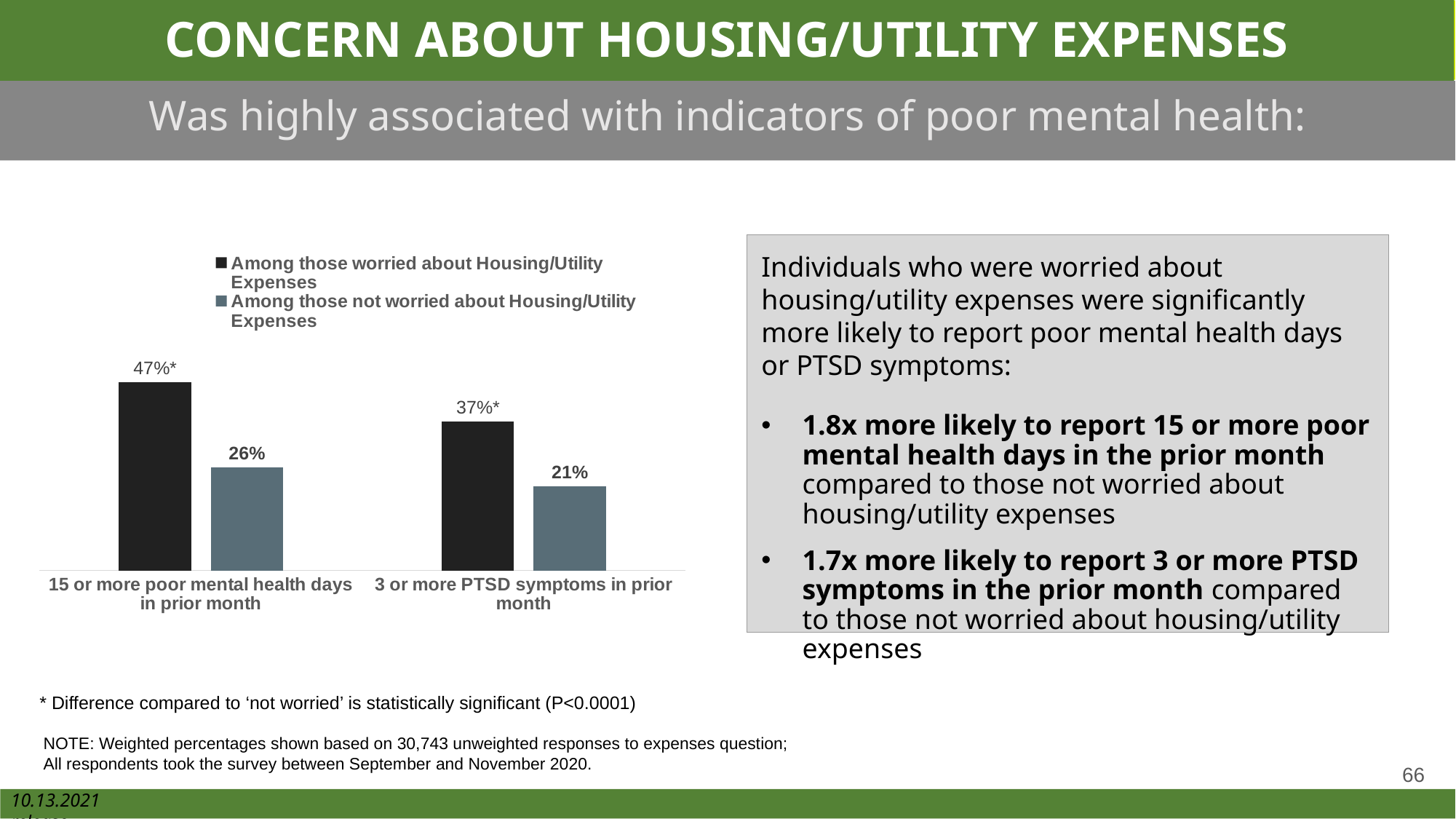
How many series does the chart legend list? 2 Which bar in the chart has the highest value? Among those worried about Housing/Utility Expenses, 15 or more poor mental health days in prior month What kind of chart is shown on the slide? Bar chart For '3 or more PTSD symptoms in prior month', which group has the larger value: those worried or those not worried about Housing/Utility Expenses? Among those worried about Housing/Utility Expenses What is the value for 'Among those worried about Housing/Utility Expenses' for '3 or more PTSD symptoms in prior month'? 37%* What is the difference between the worried and not worried values for '15 or more poor mental health days in prior month'? 21 percentage points How many categories are shown on the x axis of the chart? 2 What is the value for 'Among those worried about Housing/Utility Expenses' for '15 or more poor mental health days in prior month'? 47%* Which bar in the chart has the lowest value? Among those not worried about Housing/Utility Expenses, 3 or more PTSD symptoms in prior month What is the difference between the worried and not worried values for '3 or more PTSD symptoms in prior month'? 16 percentage points What is the value for 'Among those not worried about Housing/Utility Expenses' for '15 or more poor mental health days in prior month'? 26% What is the value for 'Among those not worried about Housing/Utility Expenses' for '3 or more PTSD symptoms in prior month'? 21%